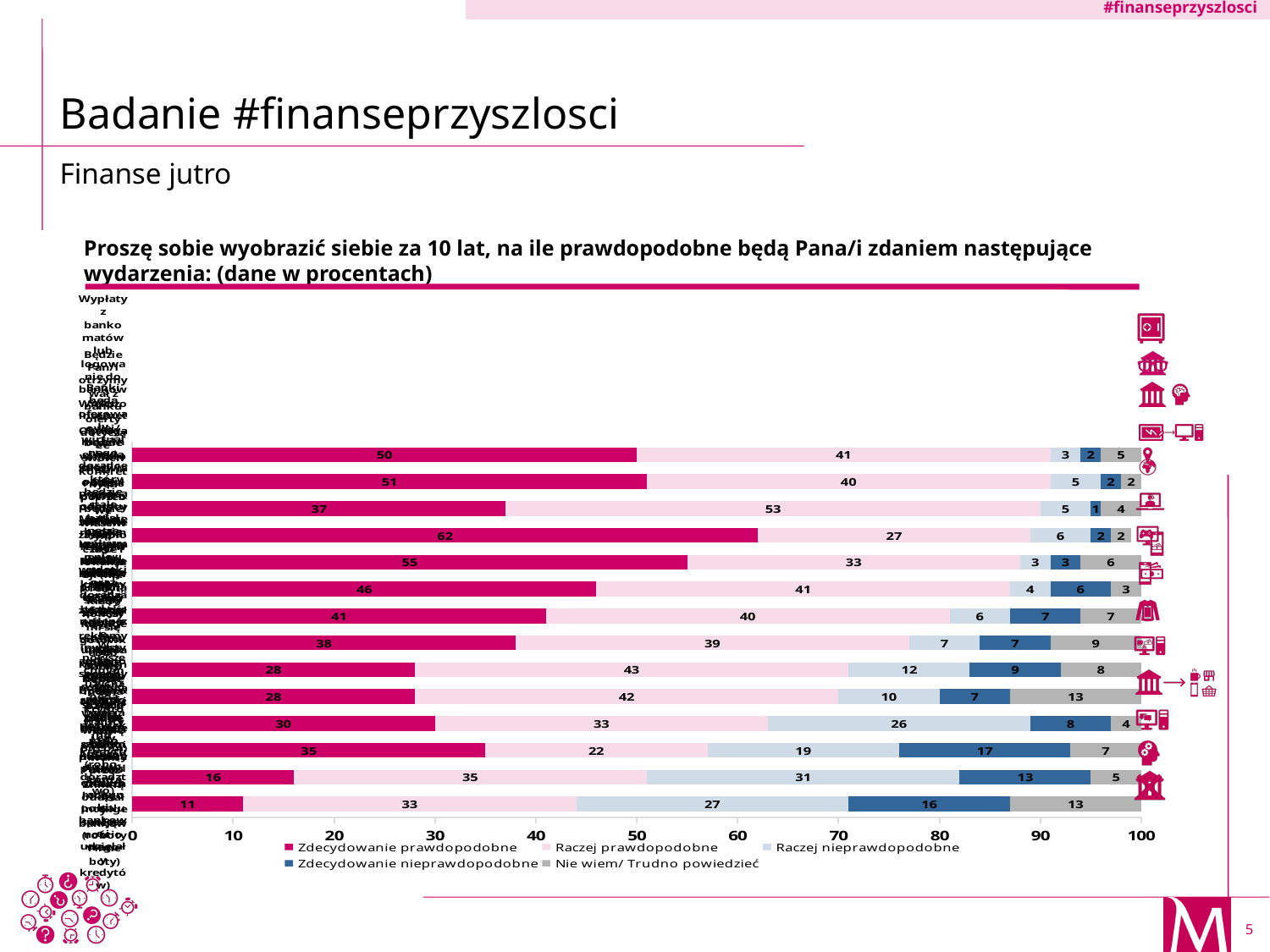
What is the difference between the 'Zdecydowanie prawdopodobne' values of the top bar and the bottom bar? 39 What is the 'Zdecydowanie prawdopodobne' value for the bottom bar of the chart? 11 What is the lowest 'Zdecydowanie prawdopodobne' value in the chart? 11 Which bar has the highest 'Zdecydowanie prawdopodobne' value, and what is it? The fourth bar from the top, 62 How many series does the chart legend list? 5 What is the total of all segments in the bottom bar of the chart? 100 What is the 'Raczej prawdopodobne' value for the third bar from the top? 53 How many bars (categories) are plotted in the chart? 14 What is the 'Zdecydowanie nieprawdopodobne' value for the second bar from the bottom? 13 What kind of chart is shown on the slide? bar chart Which has the larger 'Zdecydowanie prawdopodobne' value: the fourth bar from the top or the fifth bar from the top? The fourth bar from the top What is the 'Zdecydowanie prawdopodobne' value for the top bar of the chart? 50